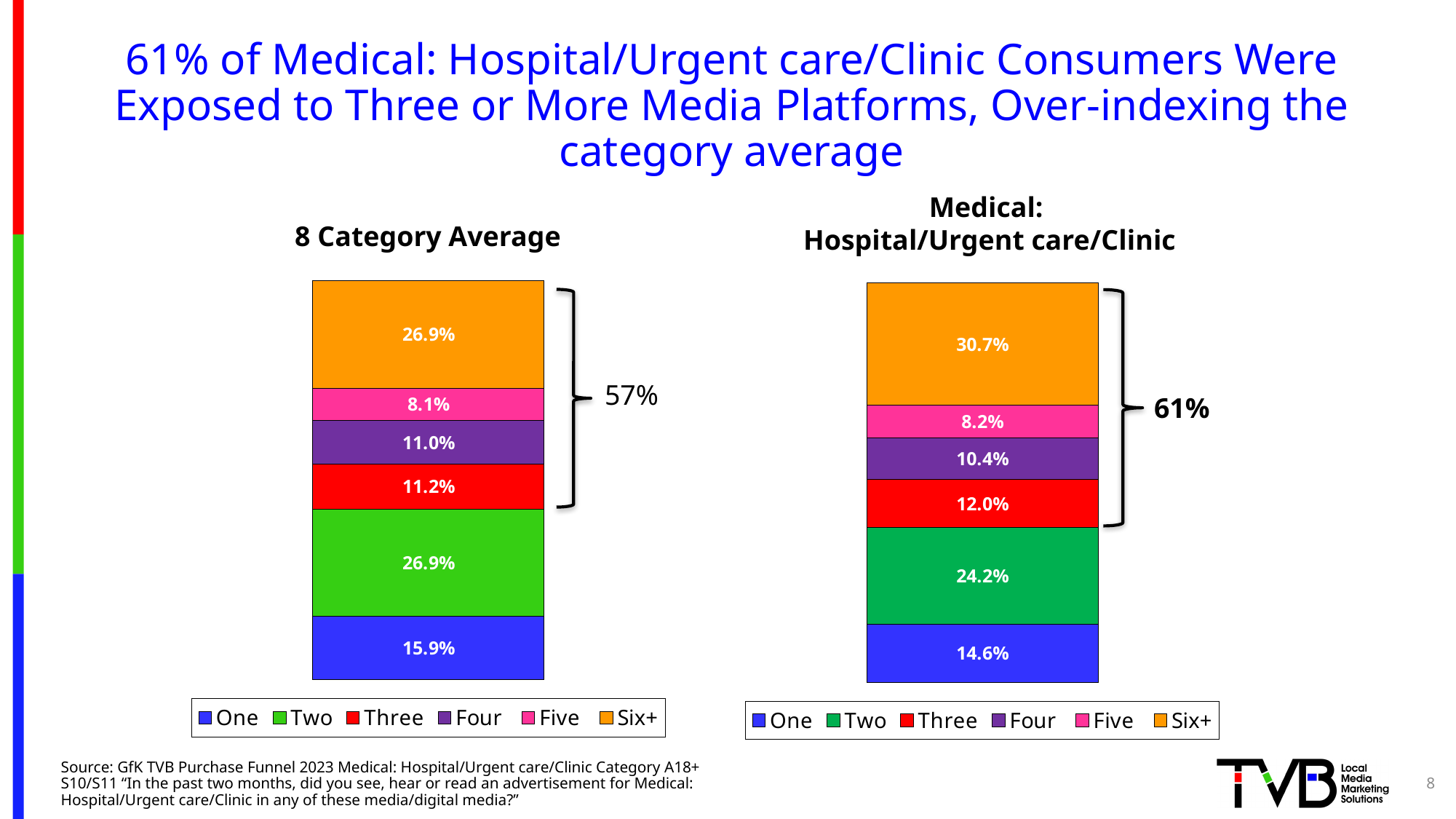
How many series does the legend of the 'Medical: Hospital/Urgent care/Clinic' chart list? 6 In the 'Medical: Hospital/Urgent care/Clinic' chart, what is the value for the 'One' segment? 14.6% Which is larger: the 'Two' segment in the '8 Category Average' chart or the 'Two' segment in the 'Medical: Hospital/Urgent care/Clinic' chart? 8 Category Average In the '8 Category Average' chart, what is the value for the 'Two' segment? 26.9% In the '8 Category Average' chart, which segment has the smallest value? Five In the 'Medical: Hospital/Urgent care/Clinic' chart, which segment has the largest value? Six+ In the 'Medical: Hospital/Urgent care/Clinic' chart, what is the value for the 'Six+' segment? 30.7% What type of chart is the '8 Category Average' chart? Stacked bar chart In the '8 Category Average' chart, what is the value for the 'Five' segment? 8.1% What percentage does the bracket next to the 'Medical: Hospital/Urgent care/Clinic' bar show for three or more platforms? 61% What percentage does the bracket next to the '8 Category Average' bar show for three or more platforms? 57% What is the difference between the 'Six+' value in the 'Medical: Hospital/Urgent care/Clinic' chart and the 'Six+' value in the '8 Category Average' chart? 3.8%